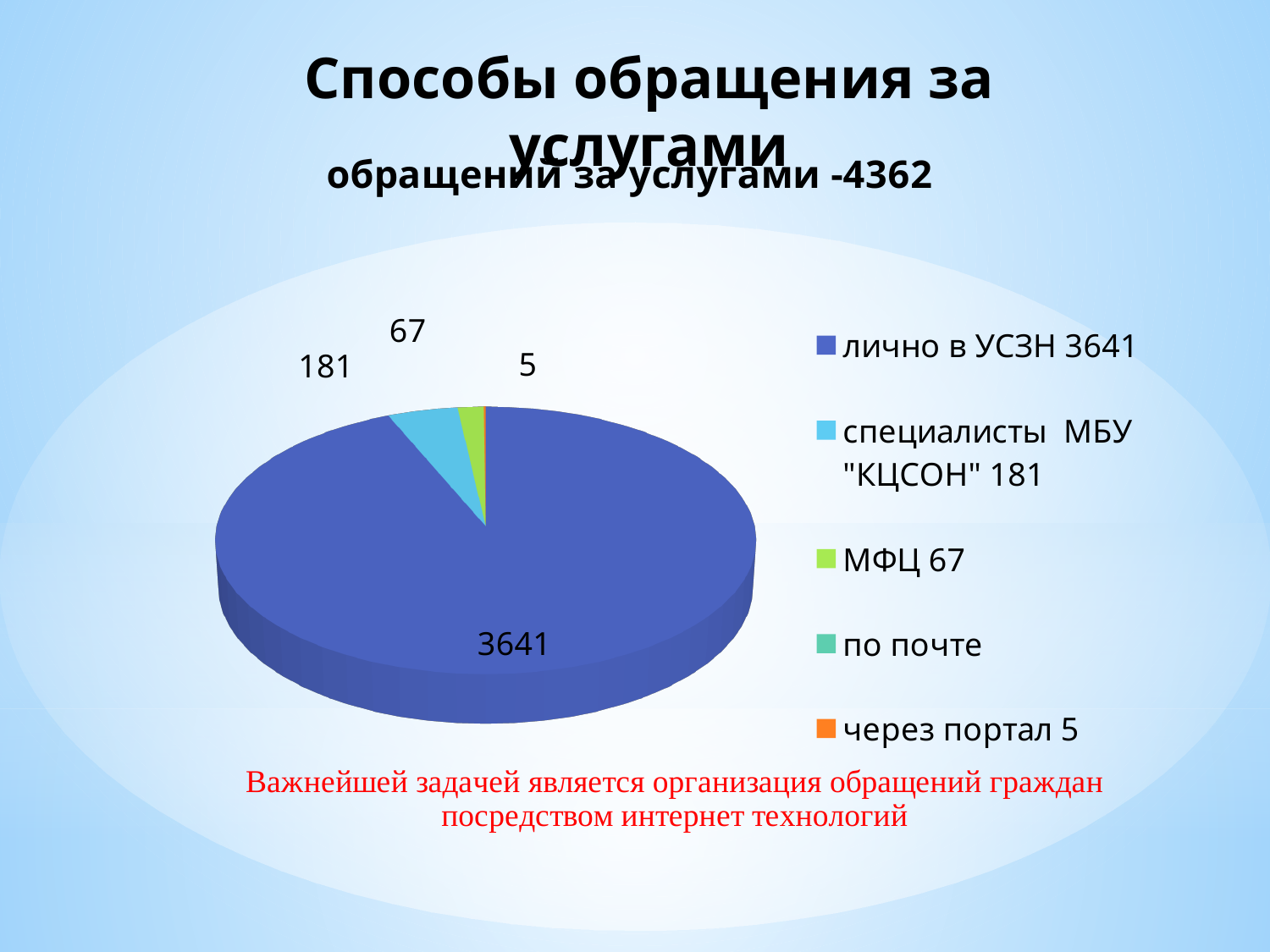
What is the value for "специалисты МБУ "КЦСОН""? 181 What kind of chart is shown on the slide? pie chart Which category has the largest slice of the pie? лично в УСЗН What total number of requests for services is stated in the chart subtitle? 4362 What is the difference between the values for "специалисты МБУ "КЦСОН"" and "МФЦ"? 114 Which is larger, the value for "МФЦ" or the value for "через портал"? МФЦ How many entries does the legend list? 5 What is the difference between the values for "лично в УСЗН" and "специалисты МБУ "КЦСОН""? 3460 What is the value for "через портал"? 5 Which labelled category has the smallest value? через портал What is the value for "лично в УСЗН"? 3641 What is the value for "МФЦ"? 67